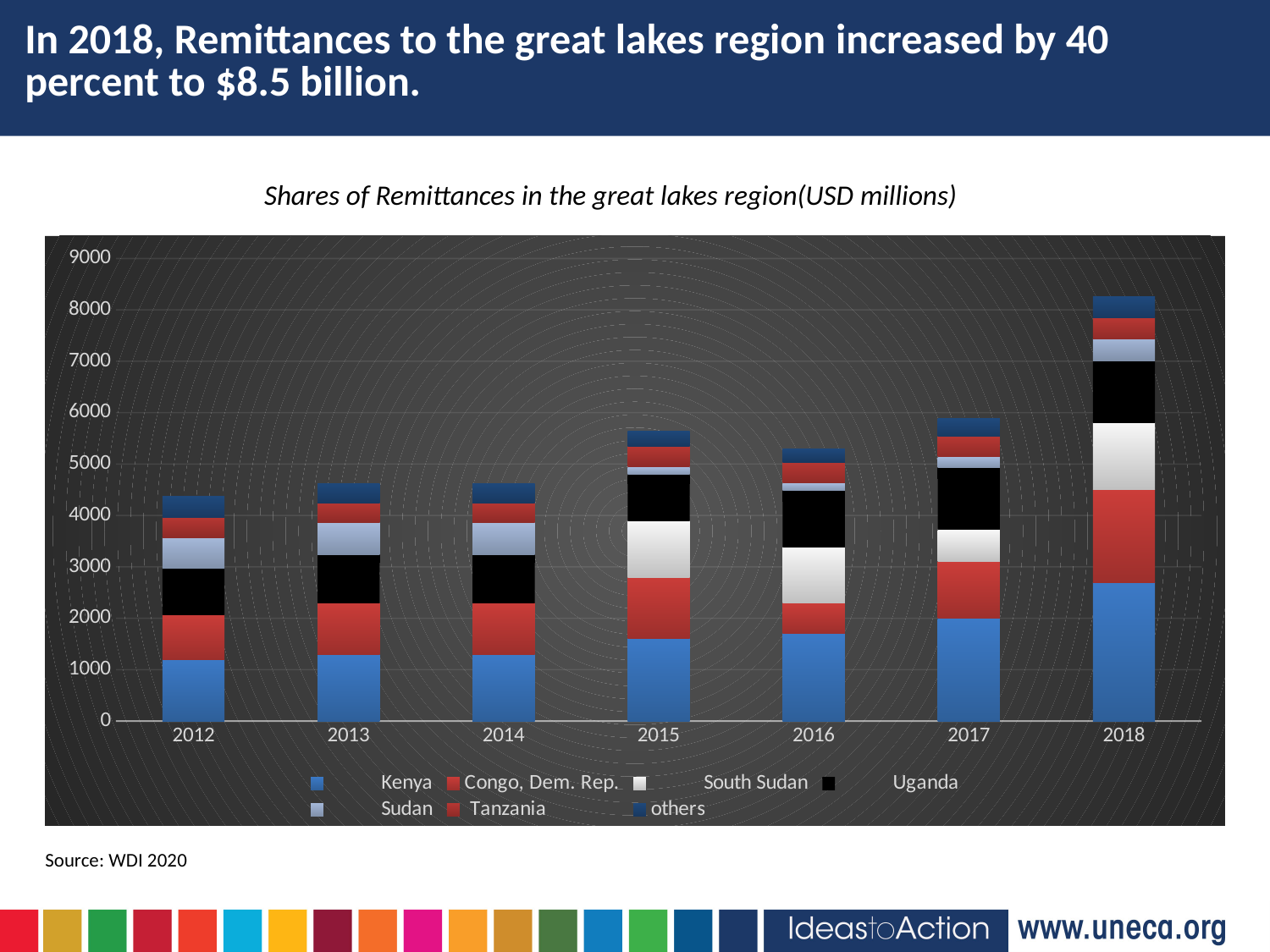
Which year has the larger total stacked bar, 2015 or 2016? 2015 Which year has the shortest stacked bar? 2012 How many series does the chart's legend list? 7 How many years are shown on the x axis of the chart? 7 Is the Kenya segment for 2018 greater or less than 2000? greater Which series is shown at the bottom of each stacked bar in blue? Kenya Do the total stacked bars rise or fall from 2016 to 2018? Rise What kind of chart is shown on the slide? Stacked bar chart What is the title of the chart? Shares of Remittances in the great lakes region(USD millions) Which year has the tallest stacked bar? 2018 Is the total stacked bar for 2018 greater or less than 8000? greater Is the total stacked bar for 2012 greater or less than 5000? less